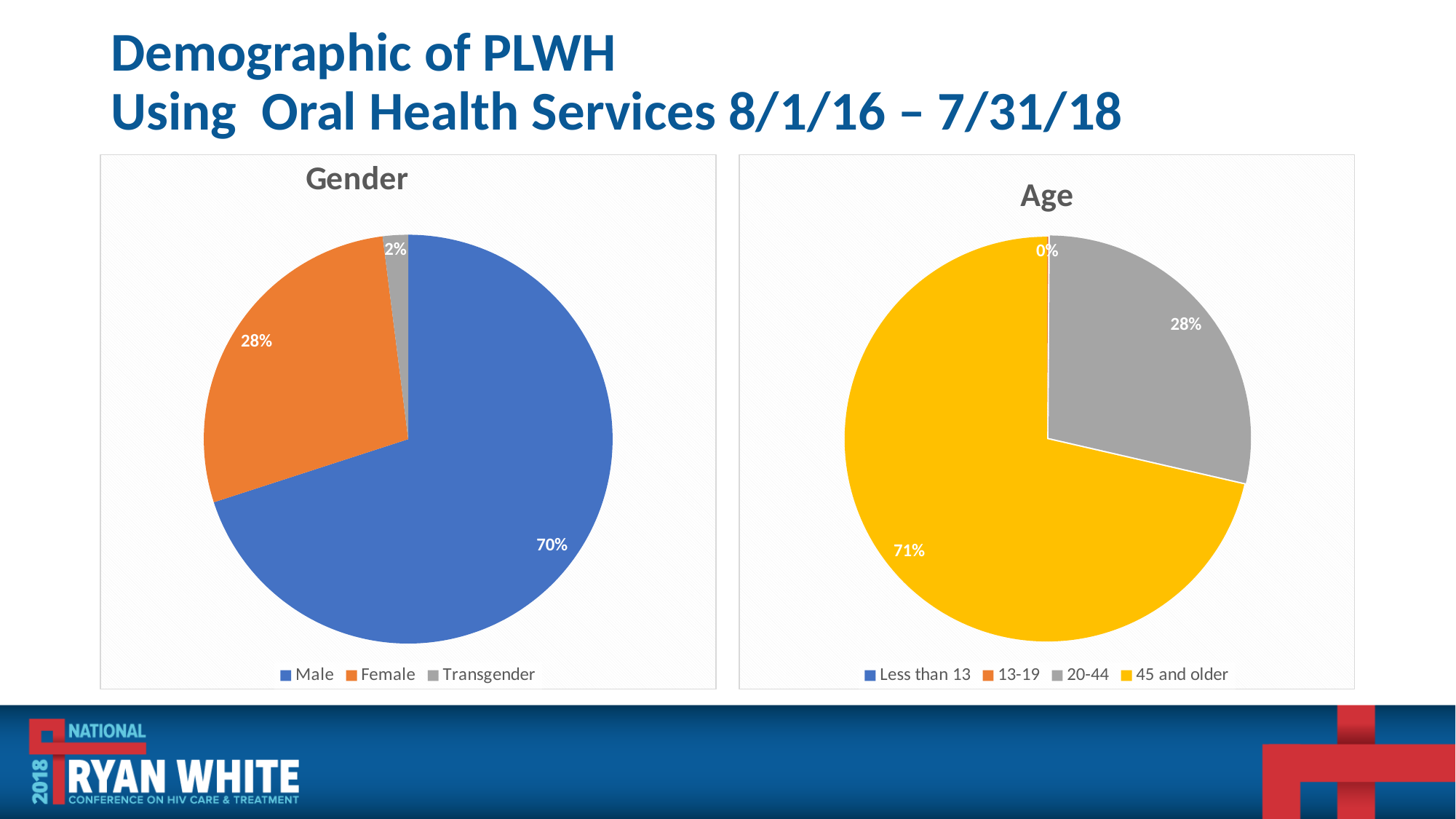
In the Gender chart, what percentage is Transgender? 2% In the Gender chart, which category has the largest share? Male In the Age chart, which is larger, 20-44 or 45 and older? 45 and older In the Gender chart, what percentage is Female? 28% In the Gender chart, what percentage is Male? 70% How many categories does the legend of the Age chart list? 4 What type of chart is the Gender chart? Pie chart In the Age chart, which age group has the largest share? 45 and older In the Gender chart, what is the difference in percentage points between Male and Female? 42 In the Age chart, what percentage is 20-44? 28% In the Gender chart, which category has the smallest share? Transgender In the Age chart, what percentage is 45 and older? 71%